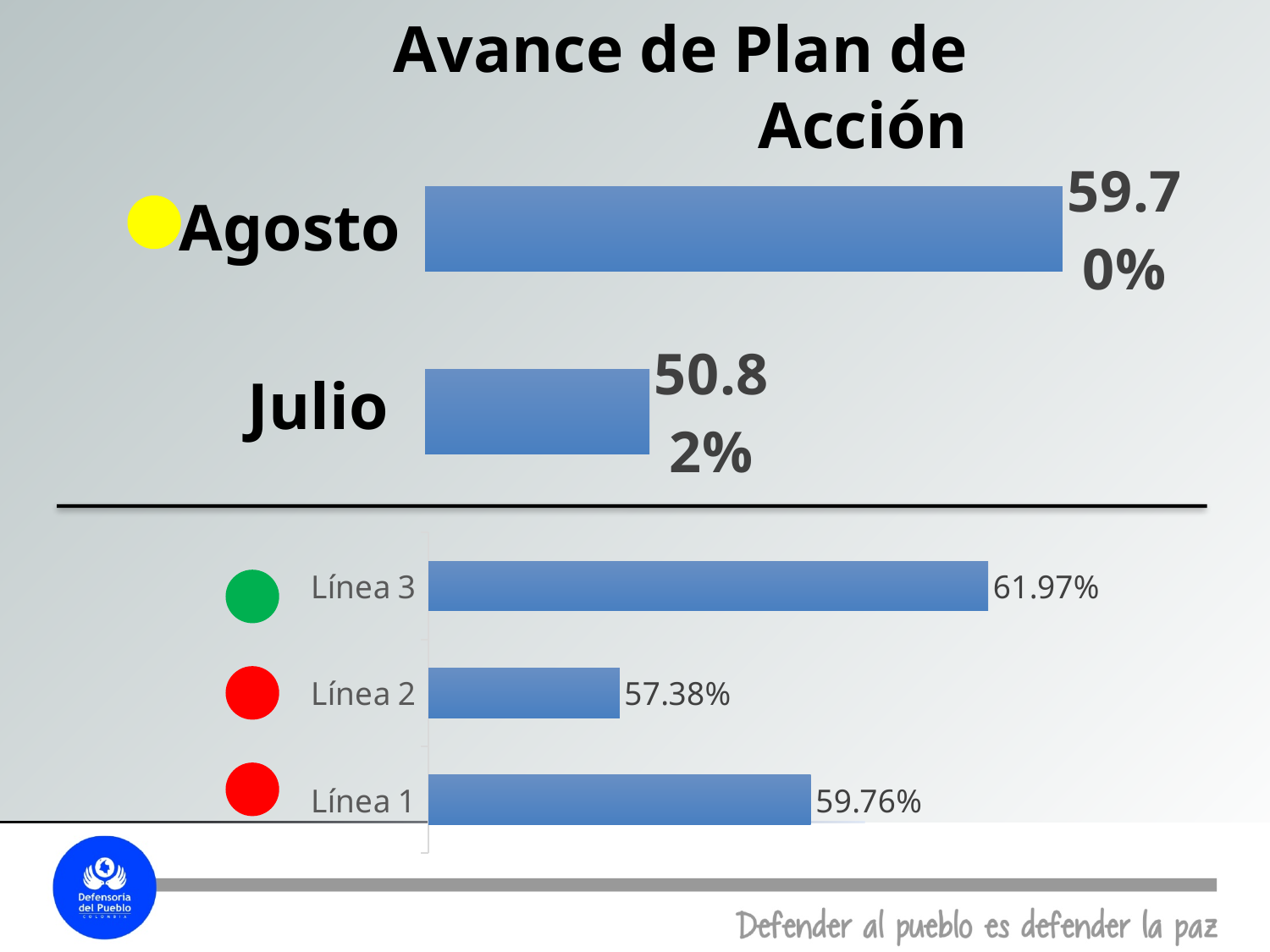
In the top chart titled 'Avance de Plan de Acción', what is the value for Julio? 50.82% In the bottom chart, what is the value for Línea 2? 57.38% In the bottom chart, what is the value for Línea 1? 59.76% In the bottom chart, what is the difference between the values for Línea 3 and Línea 2? 4.59 percentage points In the top chart titled 'Avance de Plan de Acción', what is the difference between the Agosto and Julio values? 8.88 percentage points In the bottom chart, which línea has the lowest value? Línea 2 In the top chart titled 'Avance de Plan de Acción', how many categories are plotted? 2 In the bottom chart, what is the value for Línea 3? 61.97% In the top chart titled 'Avance de Plan de Acción', which month has the higher value? Agosto What kind of chart is the top chart titled 'Avance de Plan de Acción'? Bar chart In the bottom chart, how many categories are plotted? 3 In the top chart titled 'Avance de Plan de Acción', what is the value for Agosto? 59.70%